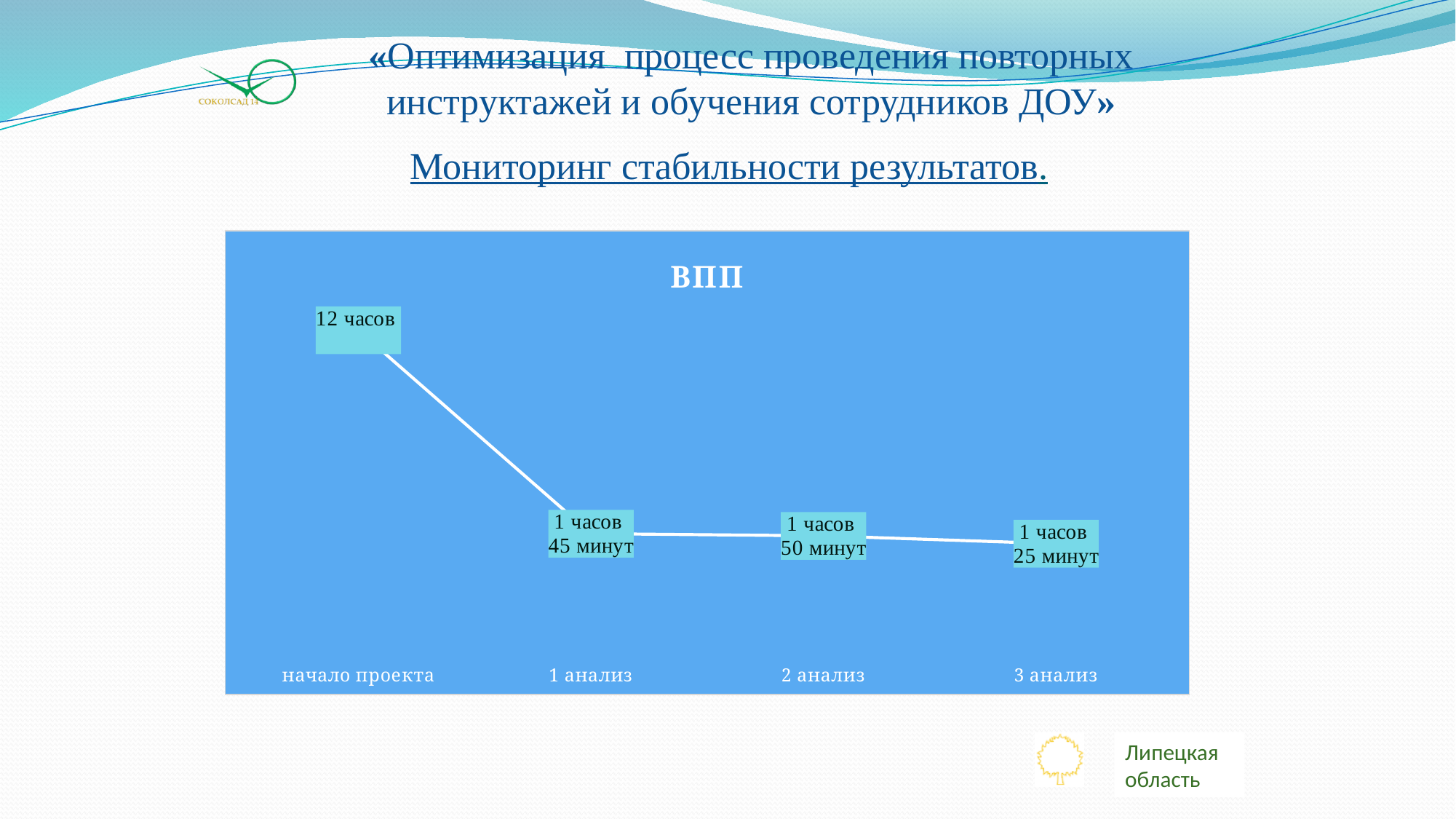
What is the value for 1 анализ? 1 часов 45 минут What is the value for начало проекта? 12 часов How many data points are plotted on the chart? 4 Which category has the highest value? начало проекта What is the difference between the values for 1 анализ and 3 анализ? 20 минут What is the title of the chart? ВПП What type of chart is shown on the slide? line chart Does the value rise or fall from начало проекта to 1 анализ? fall What is the value for 2 анализ? 1 часов 50 минут What is the value for 3 анализ? 1 часов 25 минут Which category has the lowest value? 3 анализ